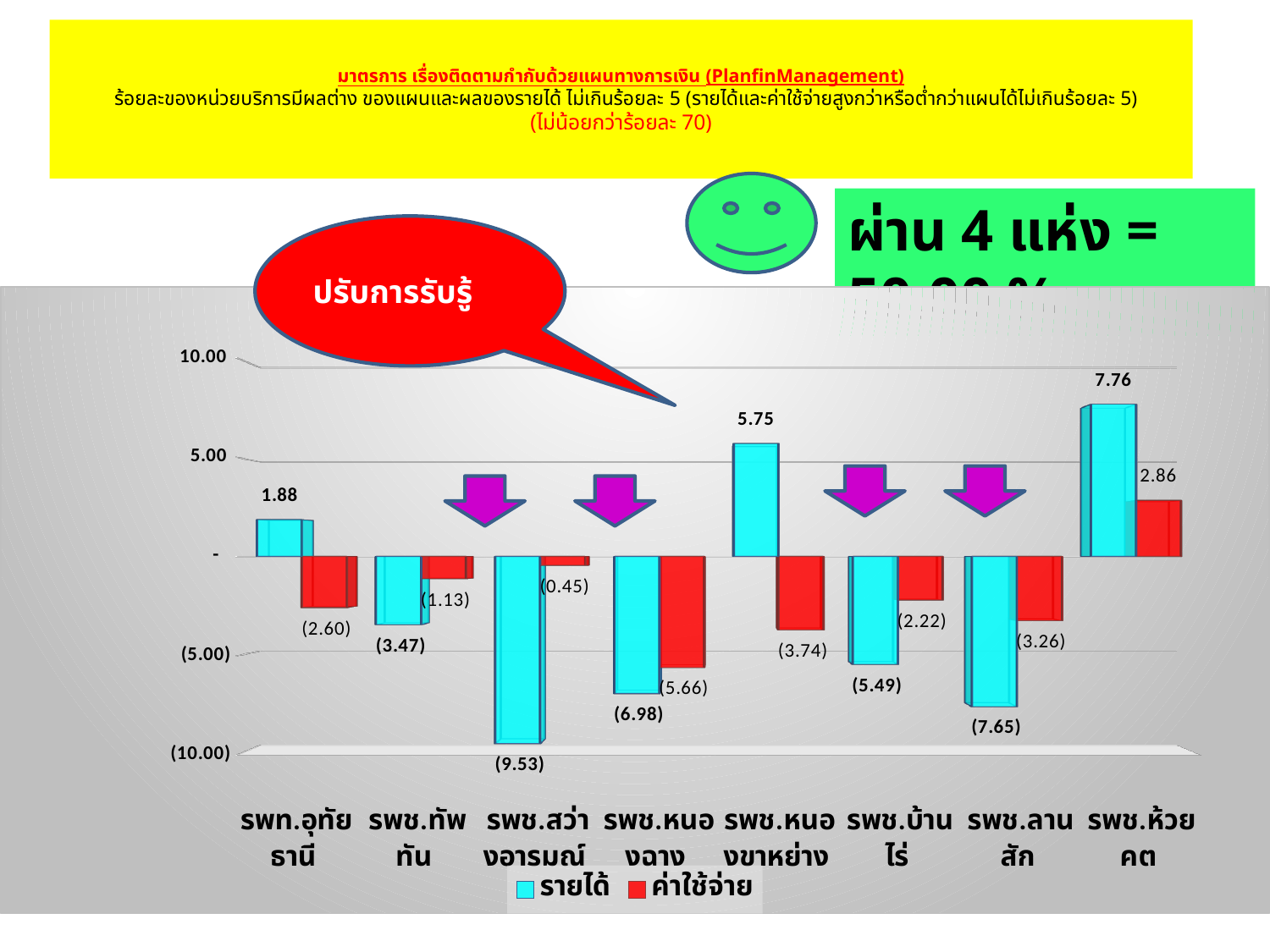
What is the ค่าใช้จ่าย value for รพช.หนองขาหย่าง? (3.74) What is the ค่าใช้จ่าย value for รพท.อุทัยธานี? (2.60) Which category has the highest รายได้ value? รพช.ห้วยคต How many series does the legend list? 2 Which category has the lowest รายได้ value? รพช.สว่างอารมณ์ Which category has the lowest ค่าใช้จ่าย value? รพช.หนองฉาง What is the รายได้ value for รพช.ห้วยคต? 7.76 How many categories (hospitals) are shown on the x axis? 8 What is the difference between the รายได้ value for รพช.ห้วยคต and the ค่าใช้จ่าย value for รพช.ห้วยคต? 4.90 What type of chart is shown on the slide? bar chart What is the รายได้ value for รพช.สว่างอารมณ์? (9.53) Which is larger, the รายได้ value for รพช.หนองขาหย่าง or the รายได้ value for รพท.อุทัยธานี? รพช.หนองขาหย่าง